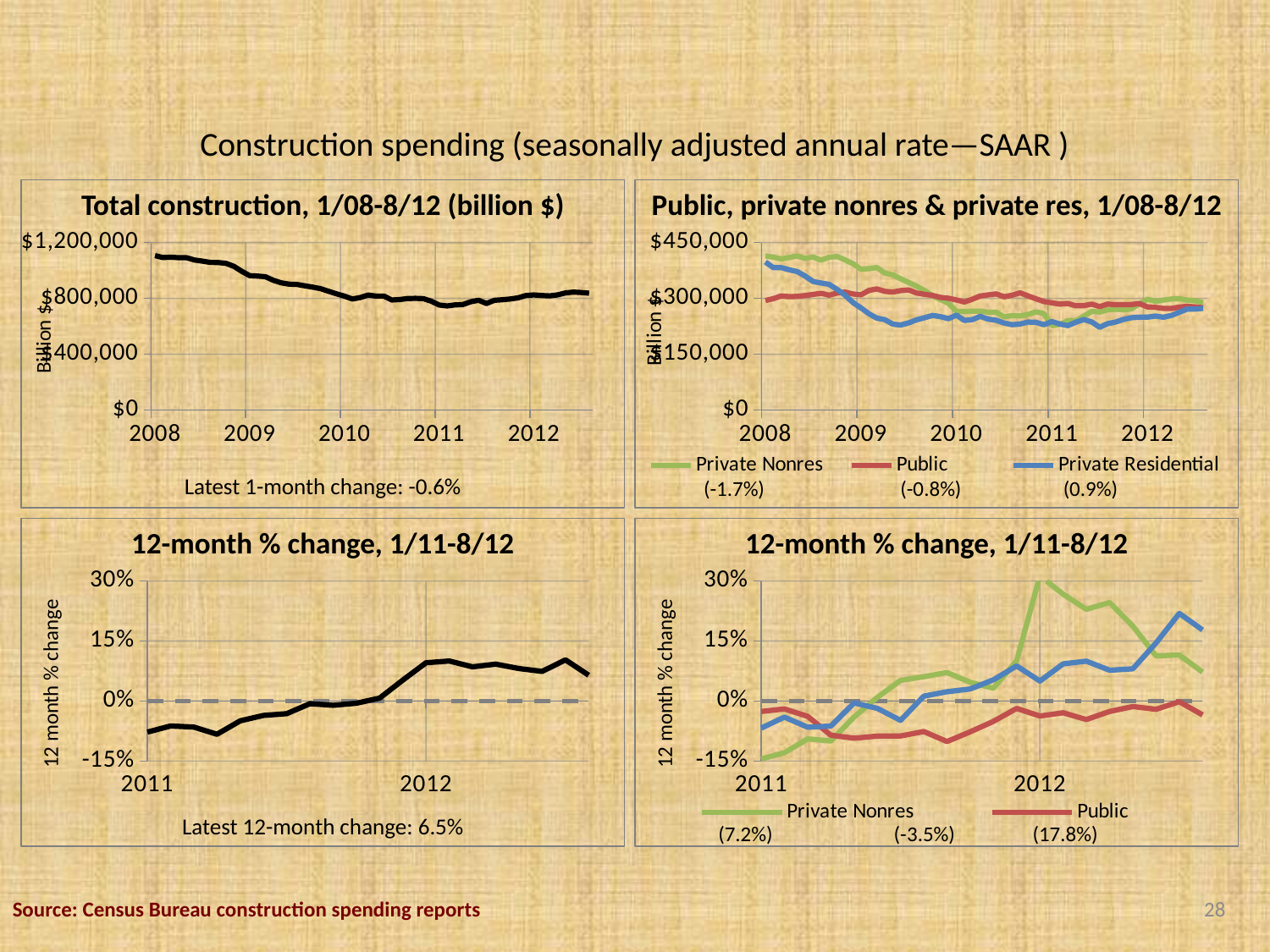
What kind of chart is the 'Total construction, 1/08-8/12 (billion $)' chart? line chart In the 'Total construction, 1/08-8/12 (billion $)' chart, do the values rise or fall from 2008 to 2010? fall What is the latest 1-month change shown on the 'Total construction, 1/08-8/12 (billion $)' chart? -0.6% In the 'Public, private nonres & private res, 1/08-8/12' chart, is the Private Residential value at 2010 greater or less than $300,000? less How many series does the legend of the 'Public, private nonres & private res, 1/08-8/12' chart list? 3 What is the latest 12-month change shown on the bottom-left '12-month % change, 1/11-8/12' chart? 6.5% In the bottom-right '12-month % change, 1/11-8/12' chart, which series is lowest at the 2012 tick? Public In the 'Total construction, 1/08-8/12 (billion $)' chart, is the value at the start of 2008 greater or less than $800,000? greater In the 'Public, private nonres & private res, 1/08-8/12' chart, which series is lowest at the start of 2008? Public In the bottom-right '12-month % change, 1/11-8/12' chart, what value is shown in the legend for Private Nonres? 7.2% In the bottom-right '12-month % change, 1/11-8/12' chart, what value is shown in the legend for Public? -3.5% In the bottom-left '12-month % change, 1/11-8/12' chart, is the value at the start of 2011 greater or less than 0%? less